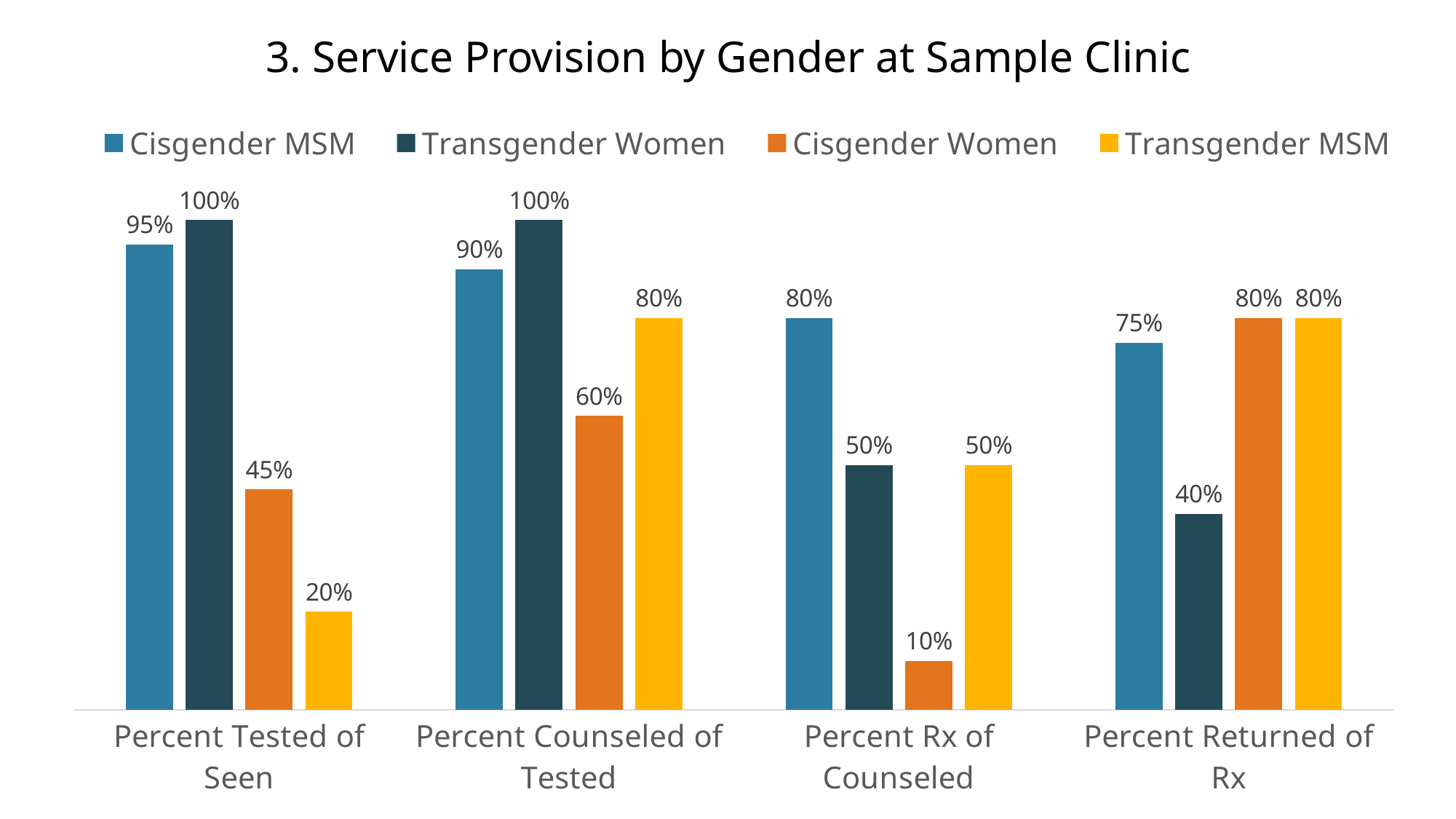
Which series has the highest value in the Percent Tested of Seen category? Transgender Women What is the value for Transgender Women in the Percent Returned of Rx category? 40% How many series does the legend list? 4 What is the value for Transgender MSM in the Percent Counseled of Tested category? 80% How many categories are shown on the x axis? 4 In the Percent Returned of Rx category, which is larger: the value for Cisgender MSM or the value for Transgender Women? Cisgender MSM Which series has the lowest value in the Percent Rx of Counseled category? Cisgender Women What is the title of the chart? 3. Service Provision by Gender at Sample Clinic What is the difference between the Cisgender MSM and Cisgender Women values in the Percent Counseled of Tested category? 30% What is the value for Cisgender Women in the Percent Tested of Seen category? 45% Do the Cisgender MSM values rise or fall across the categories from left to right? Fall What kind of chart is shown on the slide? Bar chart